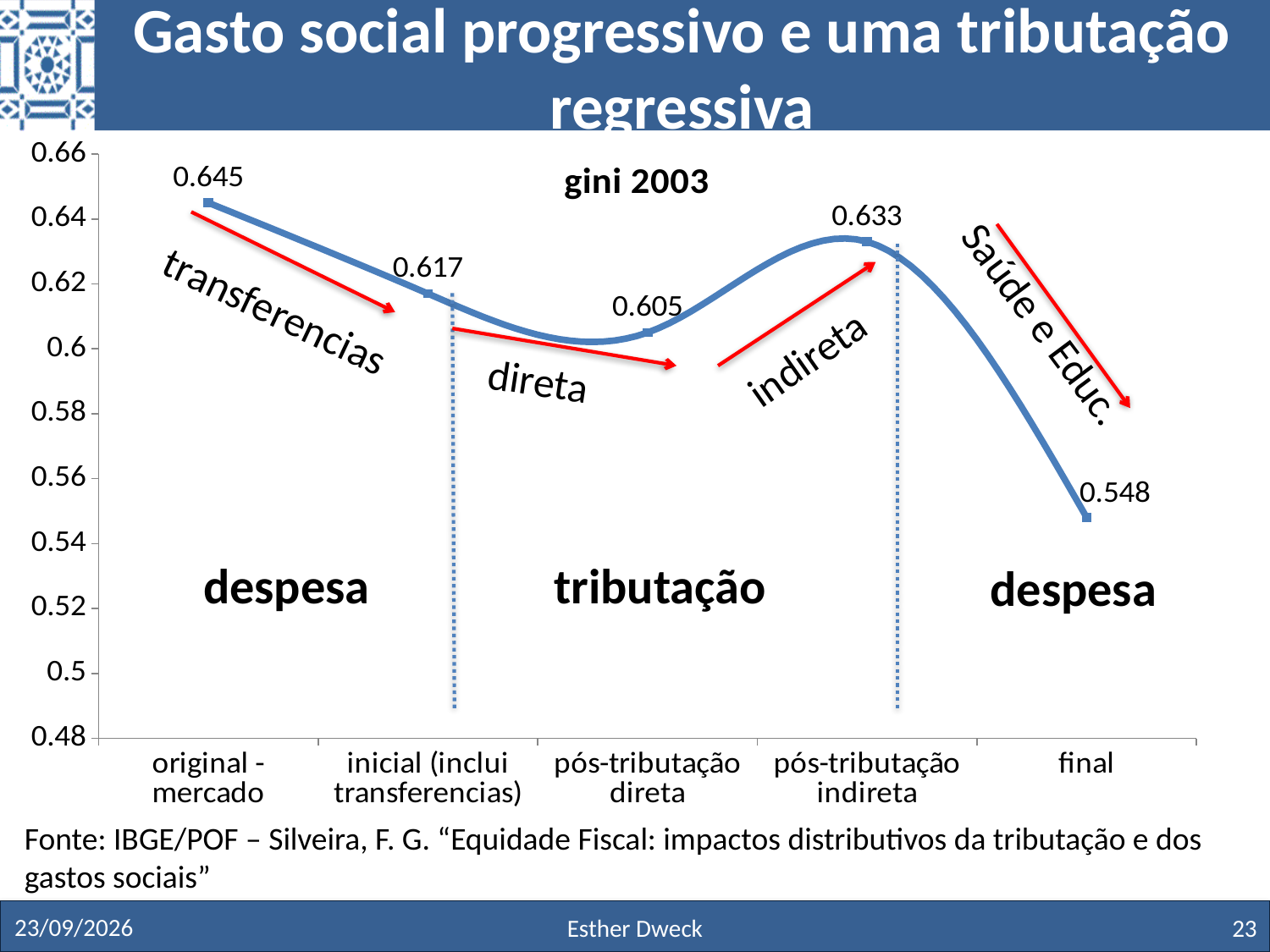
What is the Gini value for 'original - mercado'? 0.645 Which category has the highest Gini value? original - mercado Which category has the lowest Gini value? final How many categories are shown on the x axis? 5 What is the Gini value for 'pós-tributação indireta'? 0.633 Which is larger, the Gini value for 'inicial (inclui transferencias)' or for 'pós-tributação indireta'? pós-tributação indireta What is the title of the chart? gini 2003 What is the Gini value for 'pós-tributação direta'? 0.605 What kind of chart is shown on the slide? line chart What is the difference between the Gini values for 'original - mercado' and 'final'? 0.097 What is the difference between the Gini values for 'pós-tributação indireta' and 'pós-tributação direta'? 0.028 What is the Gini value for 'final'? 0.548